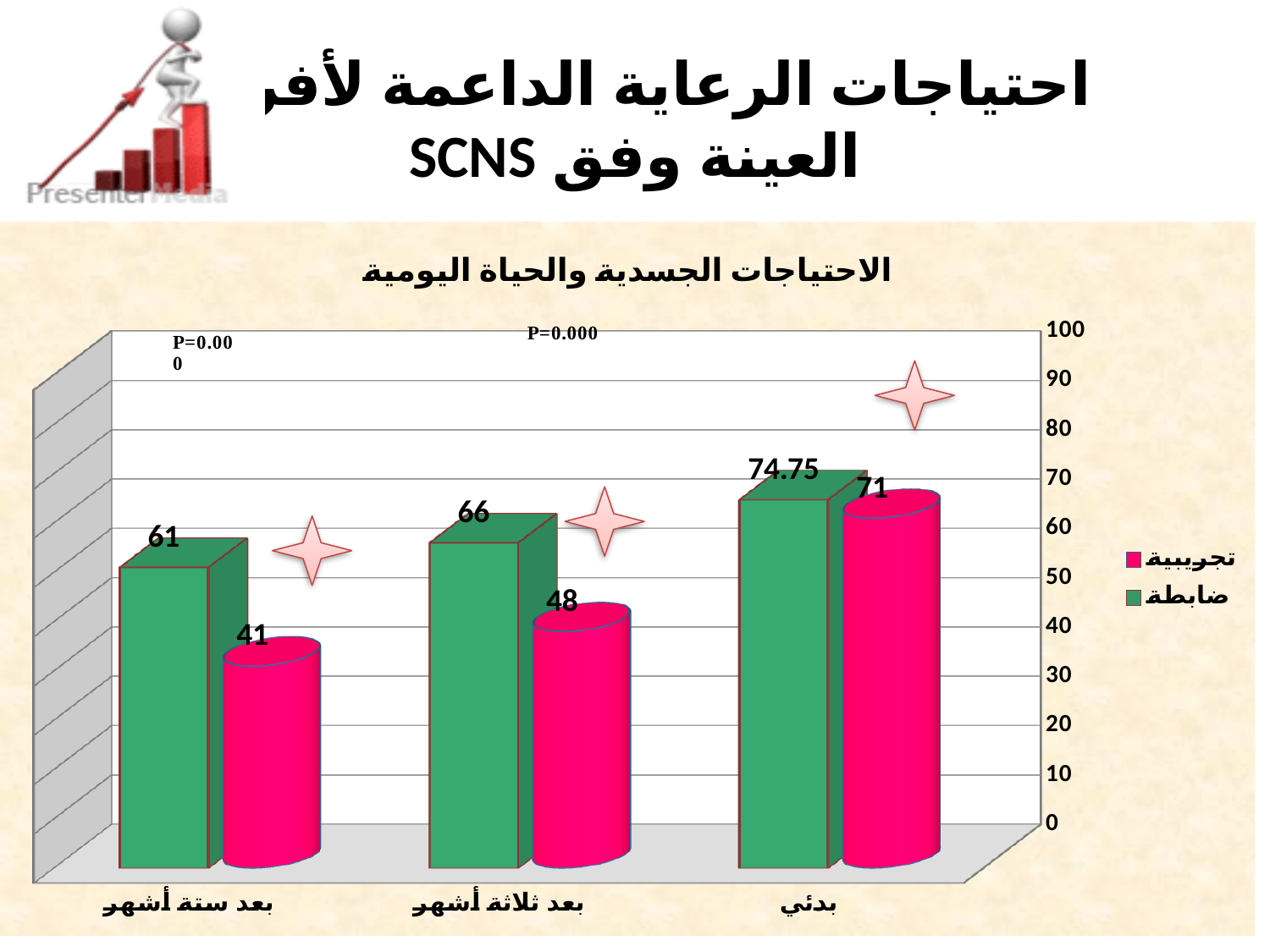
What is the value for the ضابطة series at بدئي? 74.75 How many categories are shown on the x axis? 3 What is the value for the تجريبية series at بعد ثلاثة أشهر? 48 How many series does the legend list? 2 Which series has the larger value at بعد ستة أشهر, ضابطة or تجريبية? ضابطة What is the difference between the ضابطة and تجريبية values at بعد ثلاثة أشهر? 18 What is the value for the ضابطة series at بعد ستة أشهر? 61 Which category has the lowest value for the ضابطة series? بعد ستة أشهر What is the value for the تجريبية series at بعد ستة أشهر? 41 What kind of chart is shown on the slide? bar chart What is the title of the chart? الاحتياجات الجسدية والحياة اليومية Which category has the highest value for the تجريبية series? بدئي